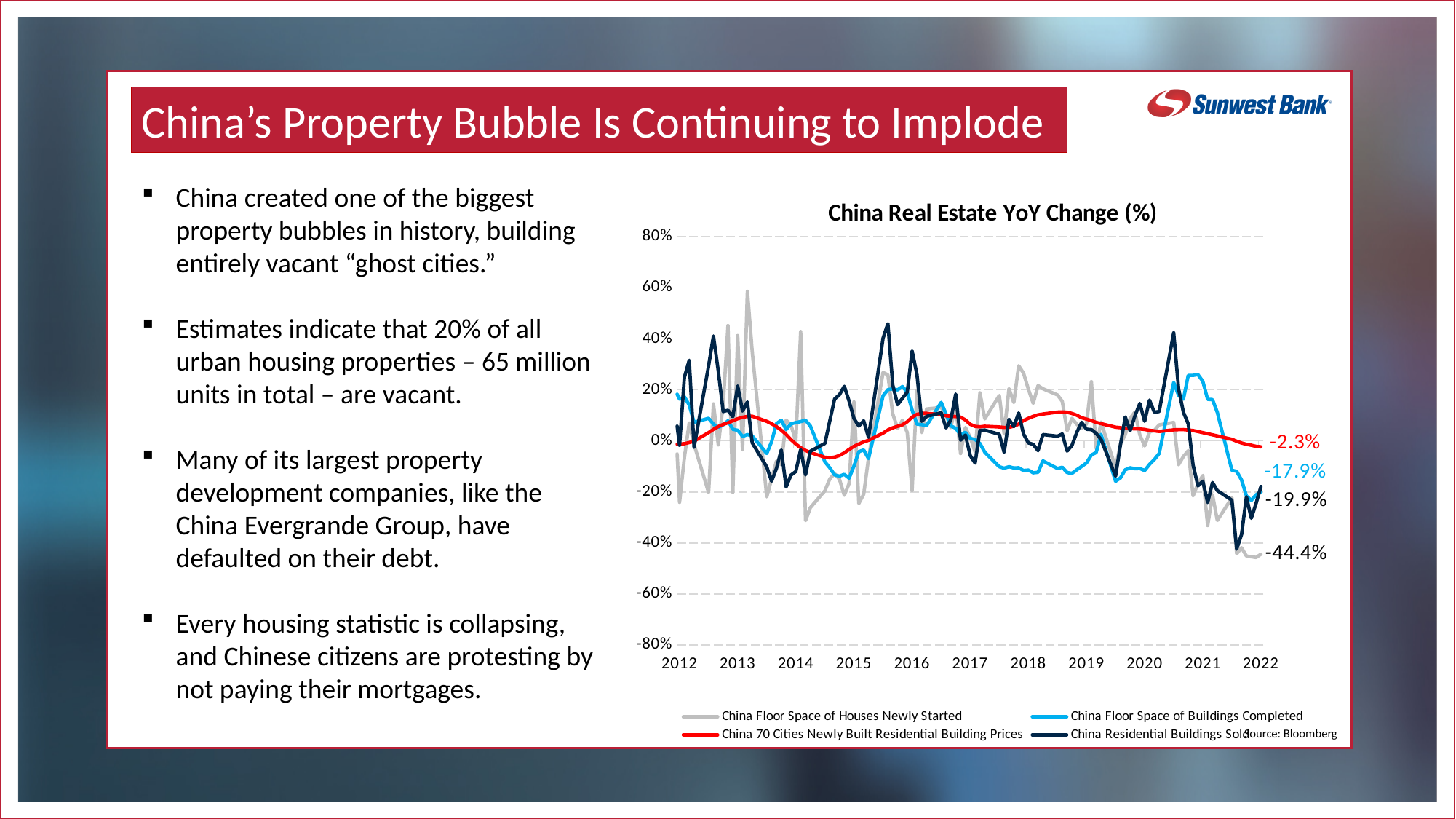
What is the latest labelled value for China Residential Buildings Sold? -17.9% Which series has the lowest labelled value at the end of the chart? China Floor Space of Houses Newly Started What kind of chart is shown on the slide? line chart Which series is drawn in red on the chart? China 70 Cities Newly Built Residential Building Prices What is the title of the chart on the slide? China Real Estate YoY Change (%) How many series does the chart's legend list? 4 What is the difference between the end-of-chart values for China Floor Space of Houses Newly Started (-44.4%) and China 70 Cities Newly Built Residential Building Prices (-2.3%)? 42.1 percentage points What is the latest labelled value for China Floor Space of Buildings Completed? -19.9% What is the latest labelled value for China 70 Cities Newly Built Residential Building Prices? -2.3% Which series has the highest labelled value at the end of the chart? China 70 Cities Newly Built Residential Building Prices Is the end-of-chart value for China Floor Space of Houses Newly Started greater or less than -40%? less What is the latest labelled value for China Floor Space of Houses Newly Started? -44.4%